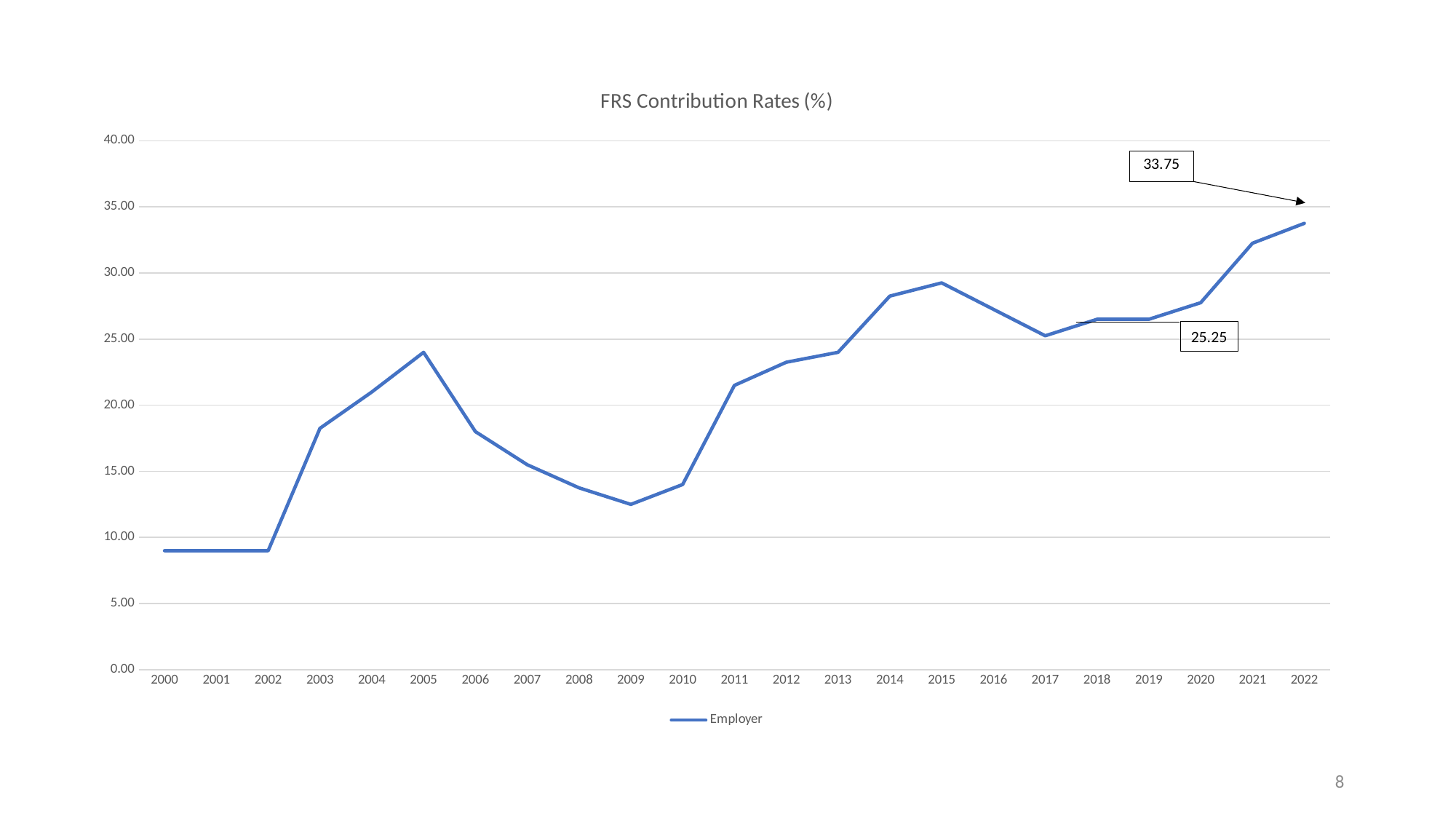
What is the title of the chart? FRS Contribution Rates (%) Which year has the highest Employer contribution rate? 2022 What kind of chart is shown on the slide? line chart How many years are plotted along the x axis? 23 What is the name of the series shown in the legend? Employer What is the Employer contribution rate for 2017? 25.25 Is the Employer rate for 2009 greater or less than 15.00? less How many series does the legend list? 1 Which year has the lowest Employer contribution rate between 2005 and 2010? 2009 What is the difference between the Employer rate in 2022 and in 2017? 8.50 Does the Employer rate rise or fall from 2005 to 2009? fall What is the Employer contribution rate for 2022? 33.75